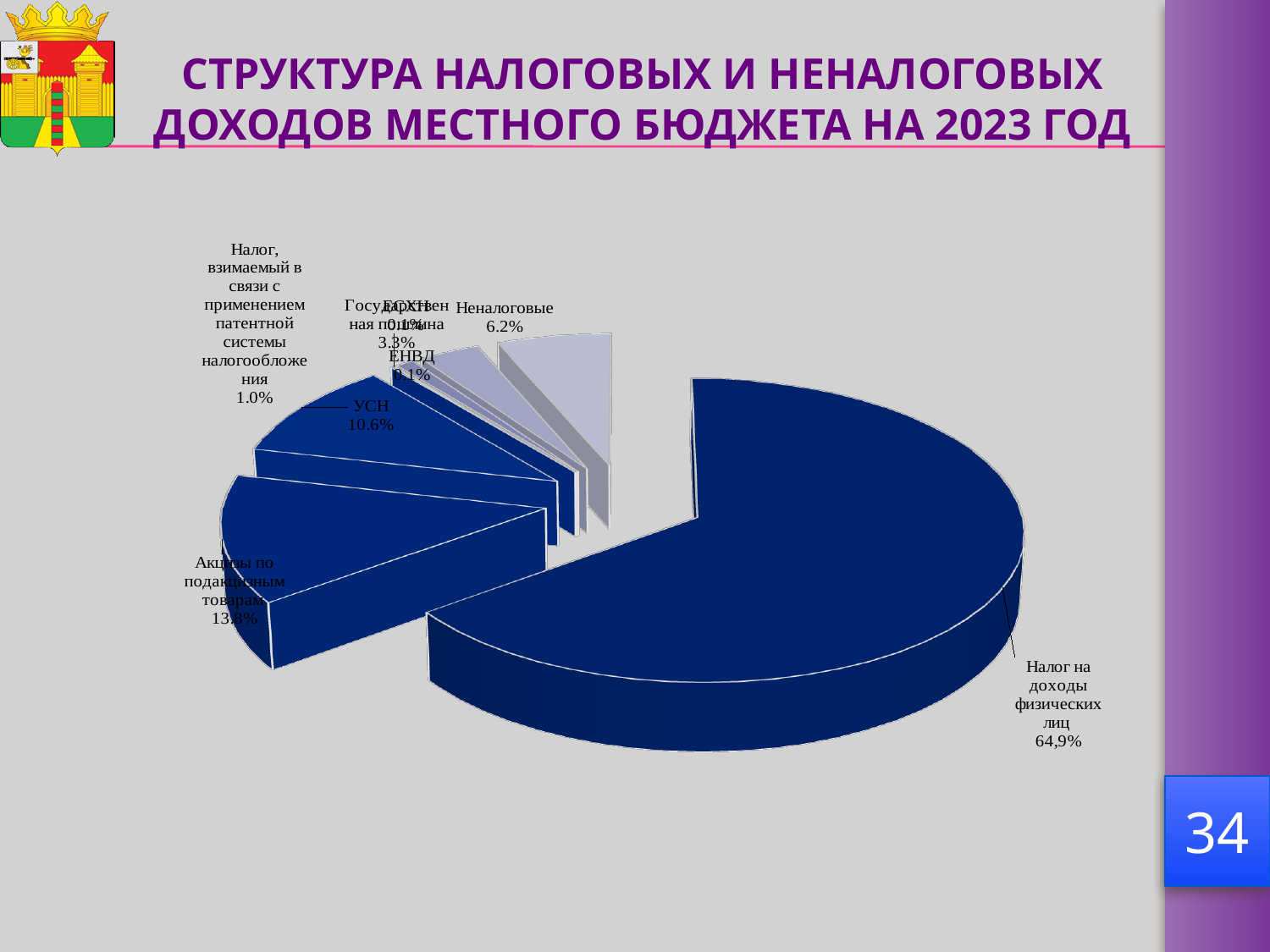
What percentage is shown for "УСН"? 10.6% By how many percentage points does the share for "УСН" exceed the share for "Неналоговые"? 4.4% What percentage is shown for "Неналоговые"? 6.2% What share of the pie is labelled for "Налог на доходы физических лиц"? 64,9% What percentage is shown for "Государственная пошлина"? 3.3% How many slices does the pie chart have? 8 Which category has the largest slice of the pie? Налог на доходы физических лиц Which is larger, the share for "УСН" or the share for "Неналоговые"? УСН What percentage is shown for "ЕНВД"? 0.1% What percentage is shown for the tax levied under the patent taxation system ("Налог, взимаемый в связи с применением патентной системы налогообложения")? 1.0% What kind of chart is shown on the slide? pie chart What is the title of the slide containing the chart? СТРУКТУРА НАЛОГОВЫХ И НЕНАЛОГОВЫХ ДОХОДОВ МЕСТНОГО БЮДЖЕТА НА 2023 ГОД